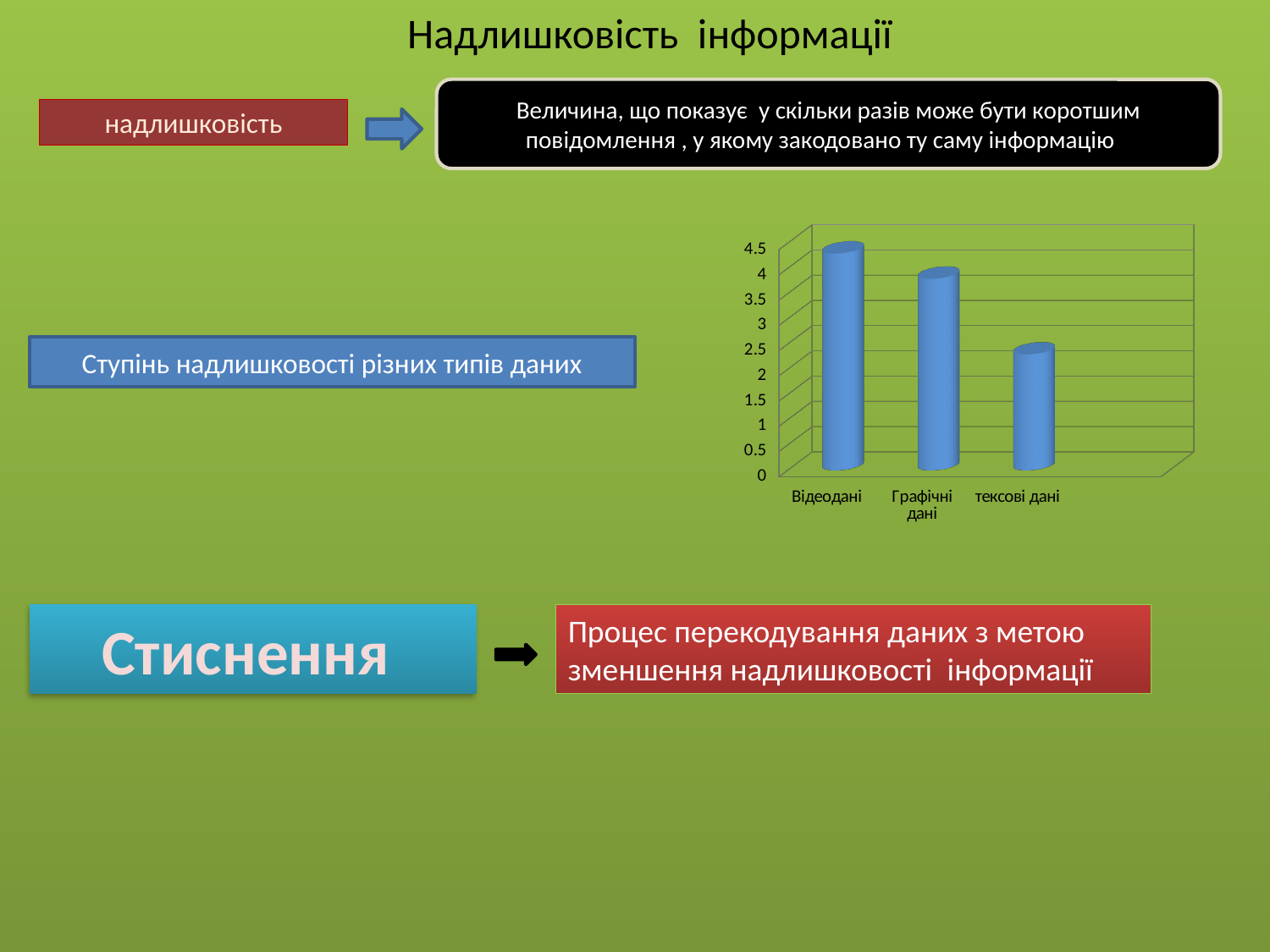
Which is larger on the chart, the value for Відеодані or the value for Графічні дані? Відеодані How many categories are plotted on the chart? 3 Which category has the highest bar on the chart? Відеодані Which category has the lowest bar on the chart? тексові дані Which is larger on the chart, the value for Графічні дані or the value for тексові дані? Графічні дані What is the highest value shown on the chart's vertical axis? 4.5 Is the value for тексові дані greater or less than 3? less Do the bar values rise or fall from left to right across the chart? fall Is the value for тексові дані greater or less than 1.5? greater Is the value for Графічні дані greater or less than 3? greater What kind of chart is shown on the slide? bar chart